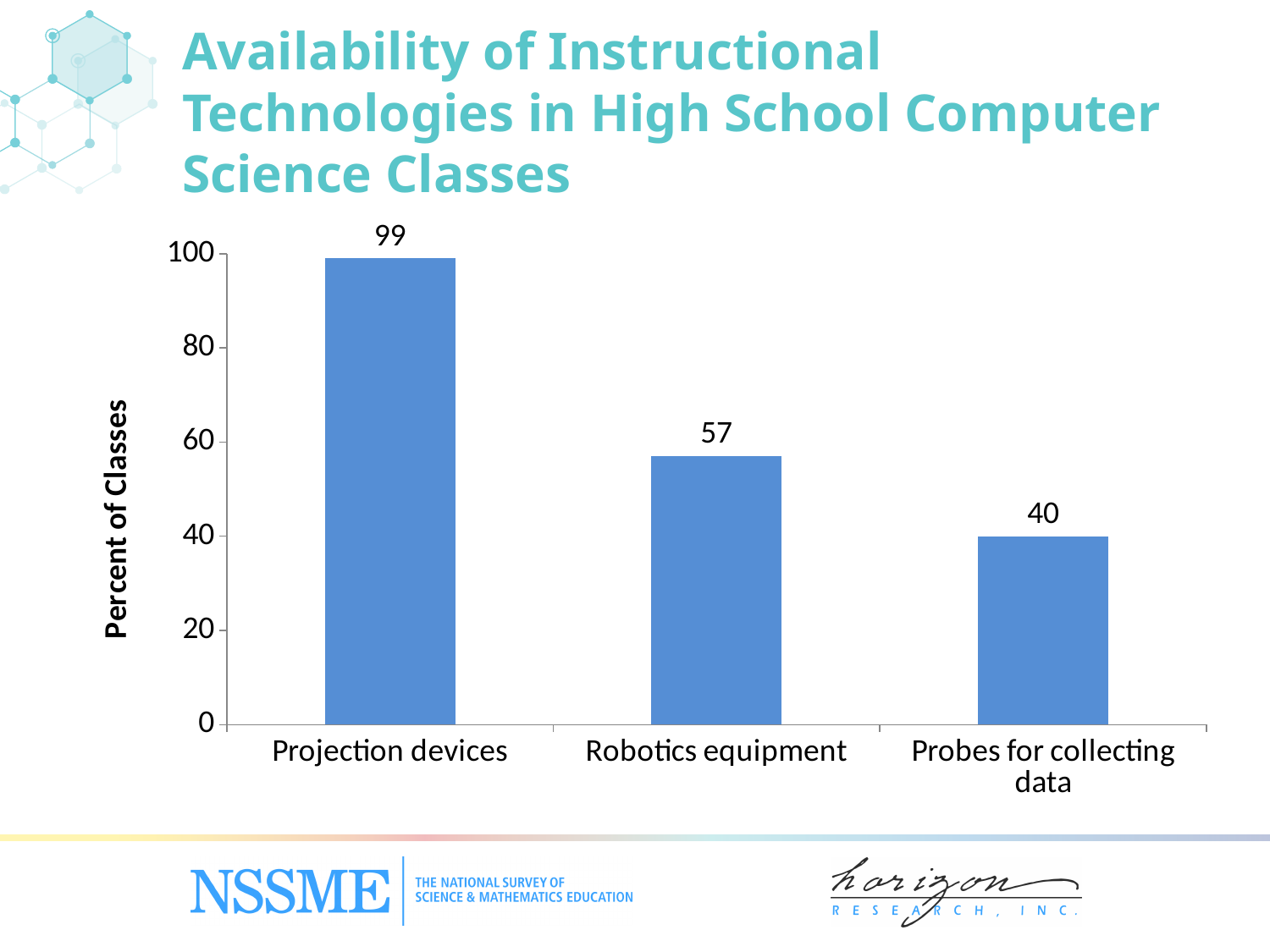
What percent of classes have projection devices available? 99 Is the value for Robotics equipment greater or less than 60? less What kind of chart is shown on the slide? Bar chart What is the label on the vertical axis of the chart? Percent of Classes How many categories are shown on the chart? 3 Which category has the highest percent of classes? Projection devices Which category has the lowest percent of classes? Probes for collecting data What is the difference between the values for Projection devices and Robotics equipment? 42 What is the difference between the values for Robotics equipment and Probes for collecting data? 17 What is the value for Robotics equipment? 57 What percent of classes have probes for collecting data available? 40 Which is larger, the value for Robotics equipment or the value for Probes for collecting data? Robotics equipment